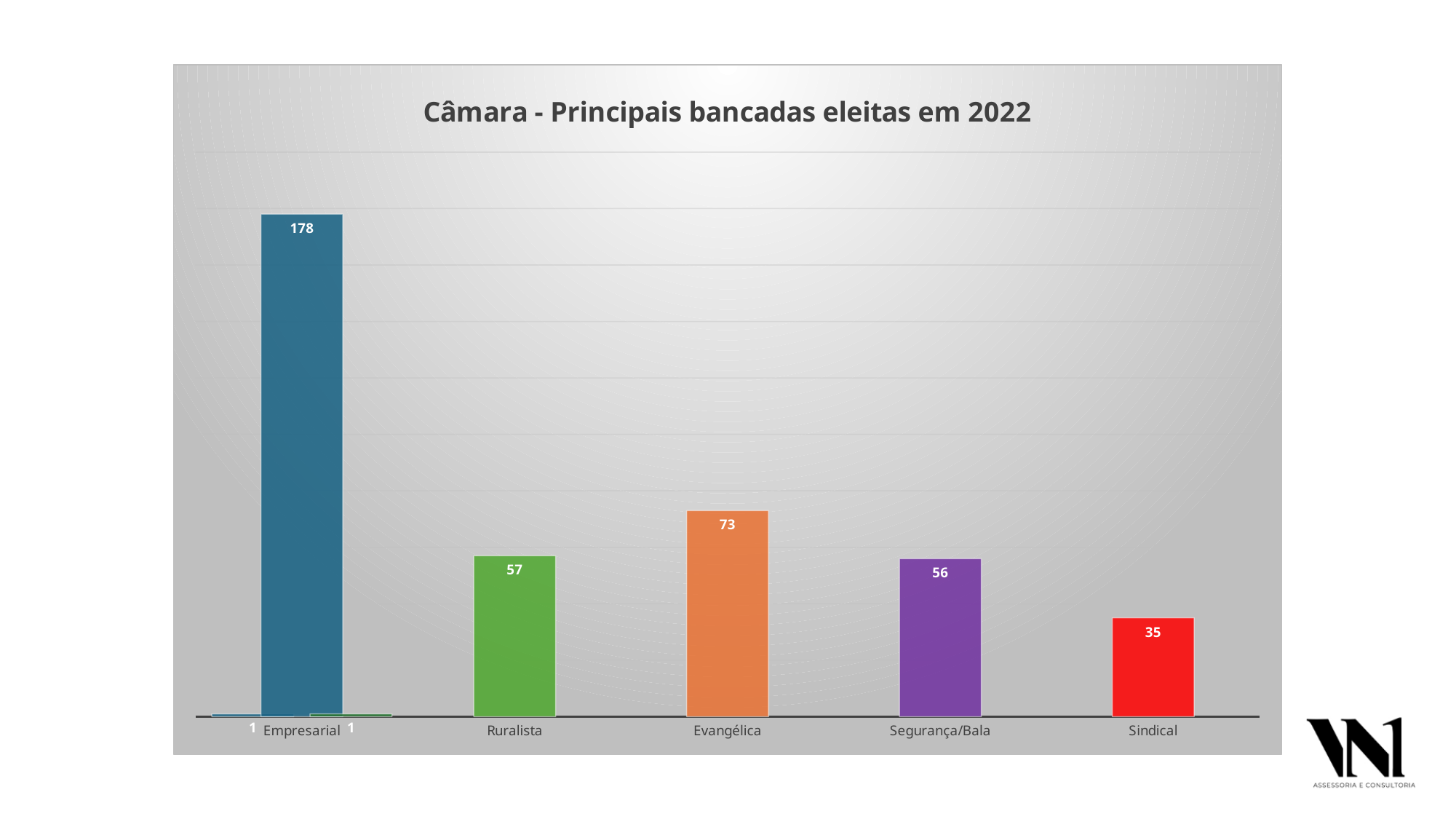
What kind of chart is shown on the slide? Bar chart What is the value for Sindical? 35 What is the value for Evangélica? 73 Which of the labeled bancadas has the lowest value? Sindical What is the value for Ruralista? 57 What is the value for Segurança/Bala? 56 Which bancada has the highest value? Empresarial What is the difference between the values for Evangélica and Sindical? 38 What is the difference between the values for Empresarial and Evangélica? 105 Which is larger, the value for Evangélica or the value for Ruralista? Evangélica What is the value for Empresarial? 178 How many bancadas are labeled on the x axis? 5